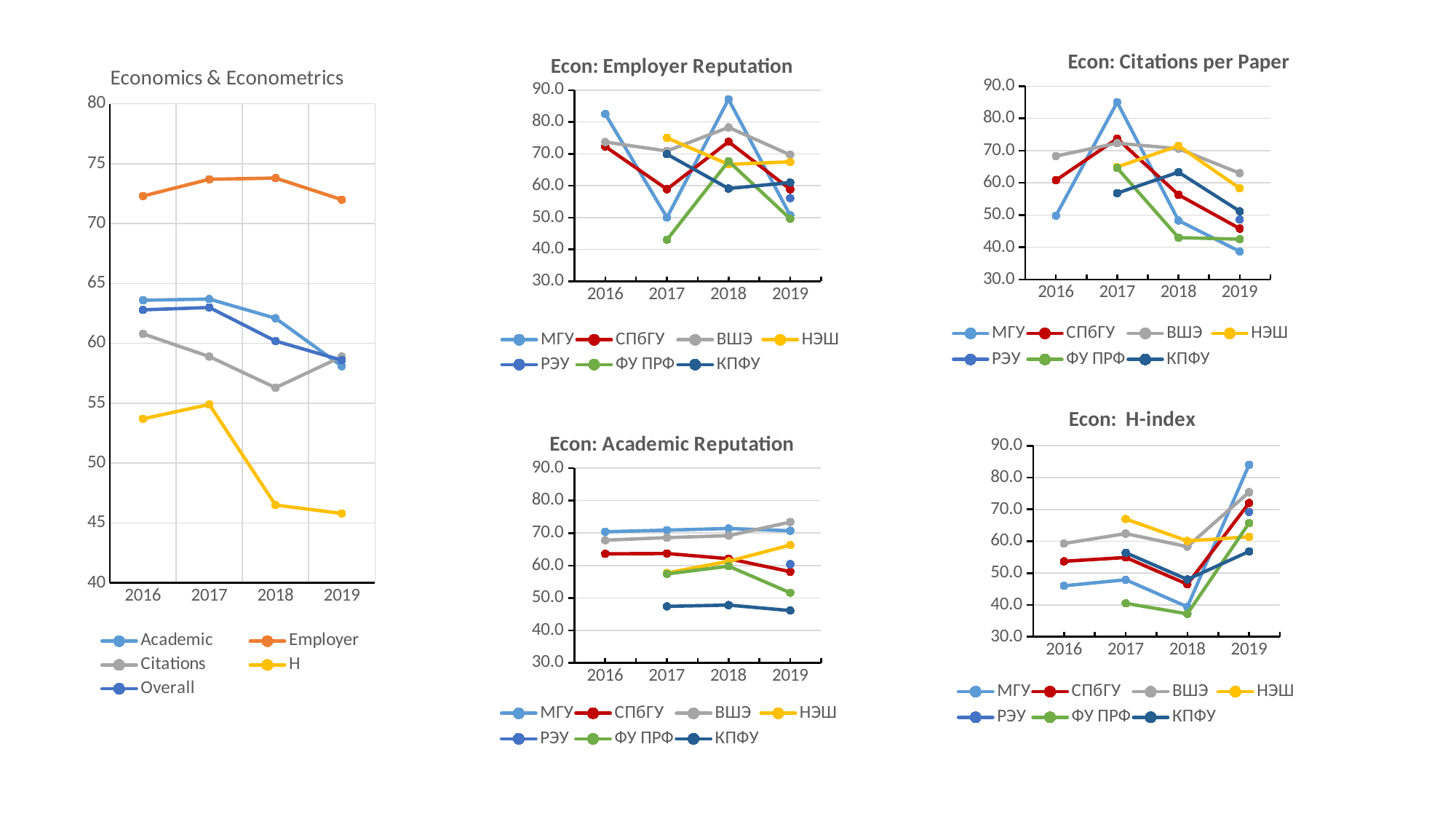
In the "Economics & Econometrics" chart, which series has the highest value in 2019? Employer In the "Economics & Econometrics" chart, does the H series rise or fall from 2017 to 2019? fall In the "Econ: Academic Reputation" chart, which series has the lowest value in 2019? КПФУ In the "Econ: Citations per Paper" chart, which is larger in 2019: МГУ or НЭШ? НЭШ In the "Econ: Citations per Paper" chart, which series has the highest value in 2017? МГУ How many series does the legend of the "Economics & Econometrics" chart list? 5 How many series does the legend of the "Econ: Employer Reputation" chart list? 7 In the "Econ: Employer Reputation" chart, which series has the highest value in 2018? МГУ In the "Economics & Econometrics" chart, is the value for H in 2018 greater or less than 50? less In the "Econ: Employer Reputation" chart, is the value for МГУ in 2017 greater or less than 60? less In the "Economics & Econometrics" chart, which series has the lowest value in 2018? H What kind of chart is the "Economics & Econometrics" chart? line chart